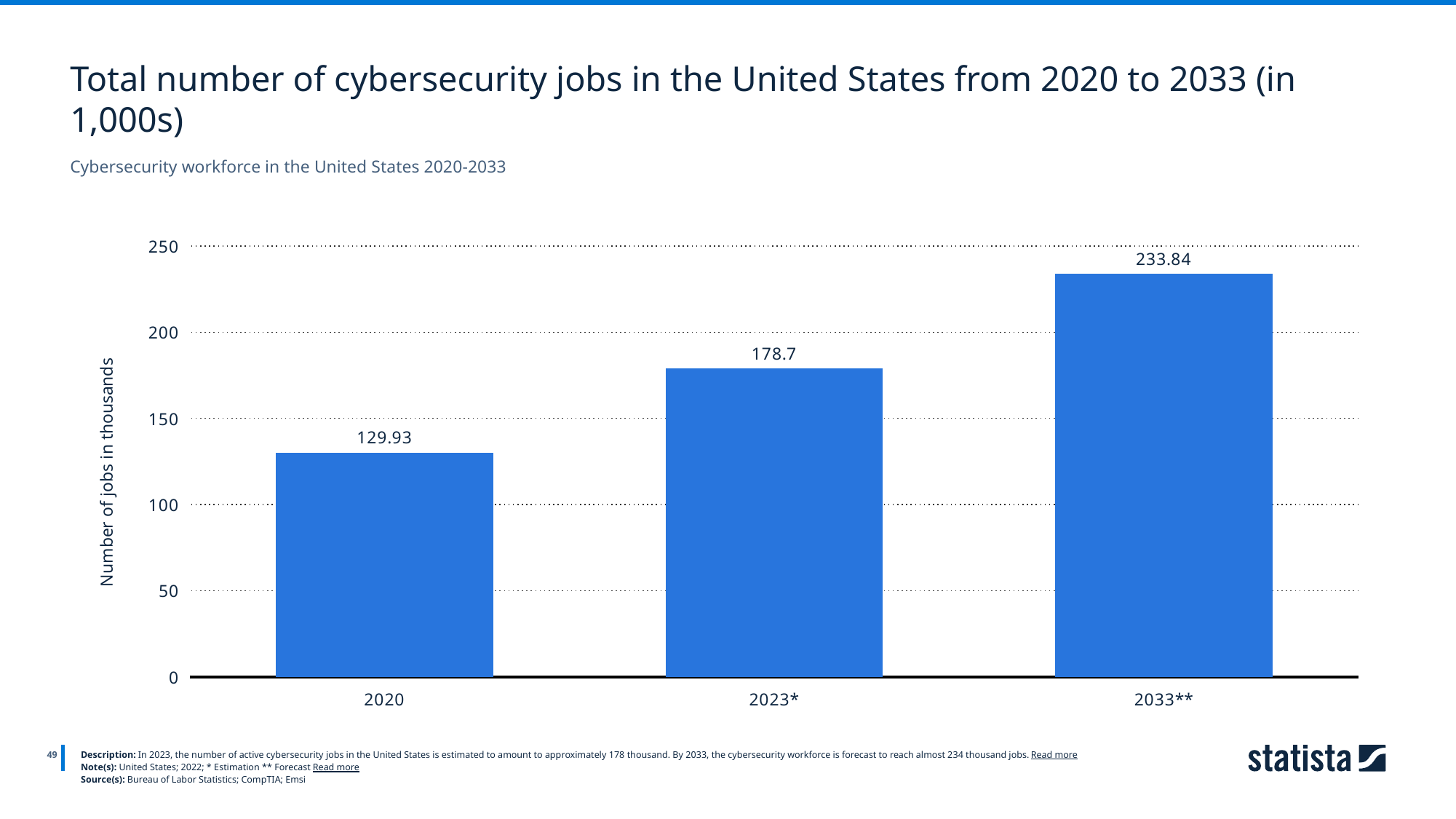
What kind of chart is shown on the slide? bar chart What is the difference between the values for 2023* and 2020? 48.77 Do the values rise or fall from 2020 to 2033**? rise What is the value for 2023*? 178.7 Is the value for 2033** greater or less than 200? greater What is the value for 2020? 129.93 What is the difference between the values for 2033** and 2020? 103.91 Which year has the lowest number of cybersecurity jobs? 2020 Which is larger, the value for 2023* or the value for 2020? 2023* How many years are shown on the x axis? 3 What is the value for 2033**? 233.84 Which year has the highest number of cybersecurity jobs? 2033**